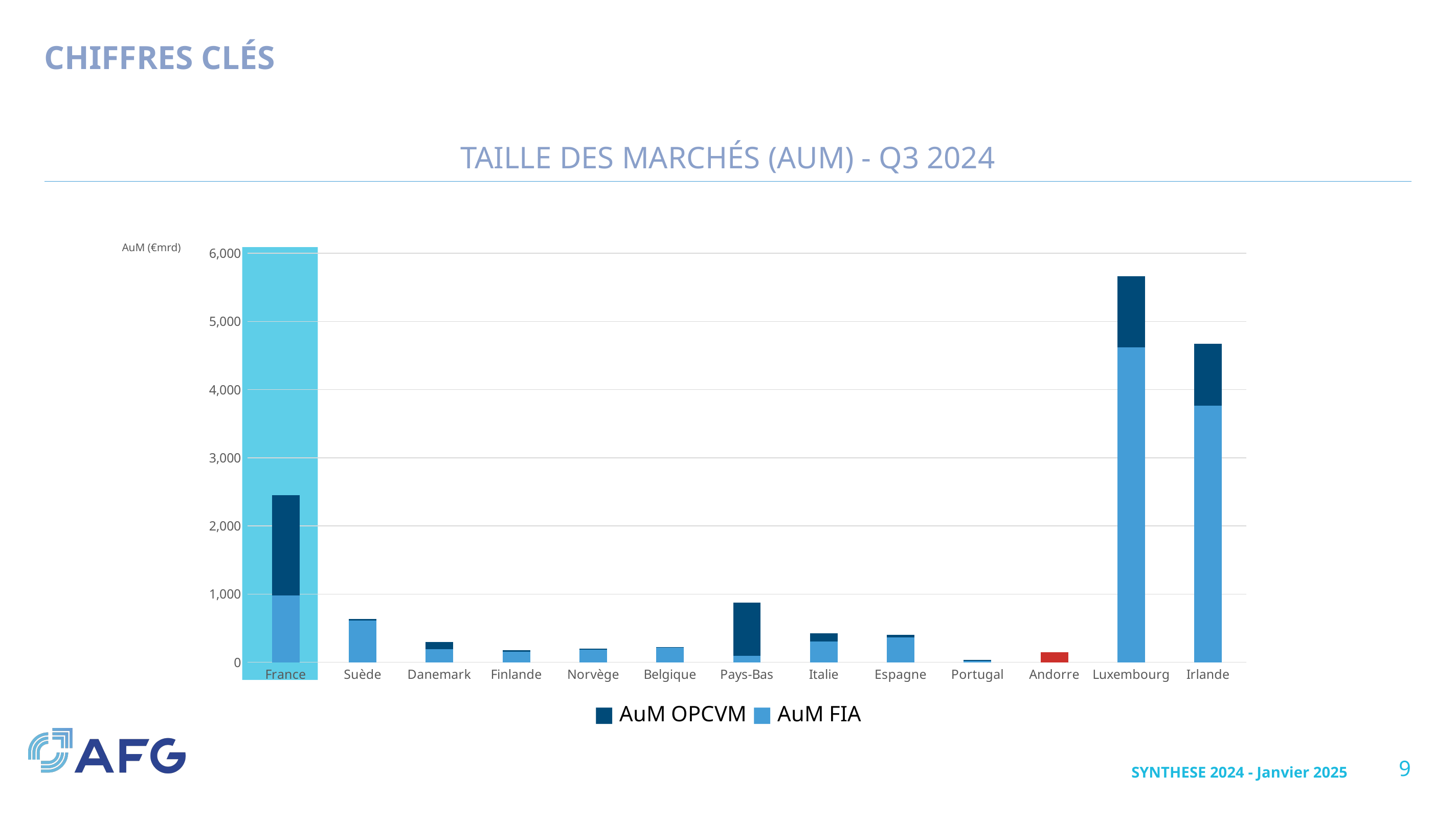
Is the total AuM for Irlande greater or less than 4,000? greater How many countries are shown on the x axis of the chart? 13 How many series does the chart legend list? 2 Is the total AuM for Luxembourg greater or less than 5,000? greater What kind of chart is shown on the slide? Stacked bar chart Which country has the highest total AuM in the chart? Luxembourg Is the total AuM for France greater or less than 3,000? less What is the title of the chart? TAILLE DES MARCHÉS (AUM) - Q3 2024 Which has the larger total AuM, Luxembourg or Irlande? Luxembourg Which has the larger total AuM, Suède or Danemark? Suède Which country has the lowest total AuM in the chart? Portugal